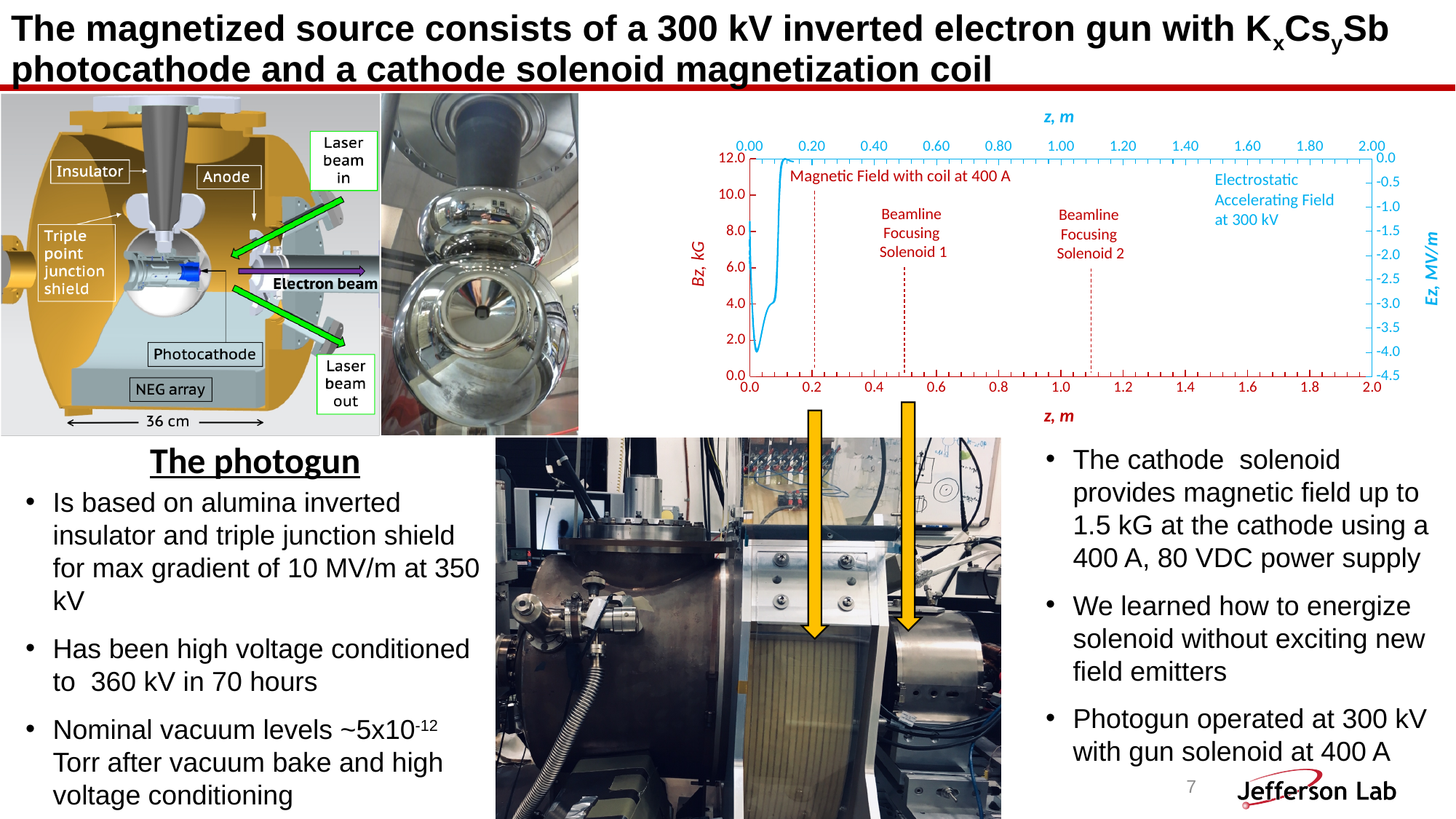
What kind of chart is shown in the upper right of the slide? line chart What is the lowest value shown on the right vertical axis (Ez) of the chart? -4.5 What is the largest z value shown on the bottom horizontal axis of the chart? 2.0 Is the z position marked for Beamline Focusing Solenoid 1 greater or less than 0.4 m? greater What is the label of the right vertical axis of the chart? Ez, MV/m According to the chart annotation, at what voltage is the electrostatic accelerating field given? 300 kV How many beamline focusing solenoids are marked on the chart? 2 What is the highest value shown on the left vertical axis (Bz) of the chart? 12.0 What is the label of the left vertical axis of the chart? Bz, kG According to the chart annotation, at what coil current was the magnetic field plotted? 400 A Is the z position marked for Beamline Focusing Solenoid 2 greater or less than 1.0 m? greater